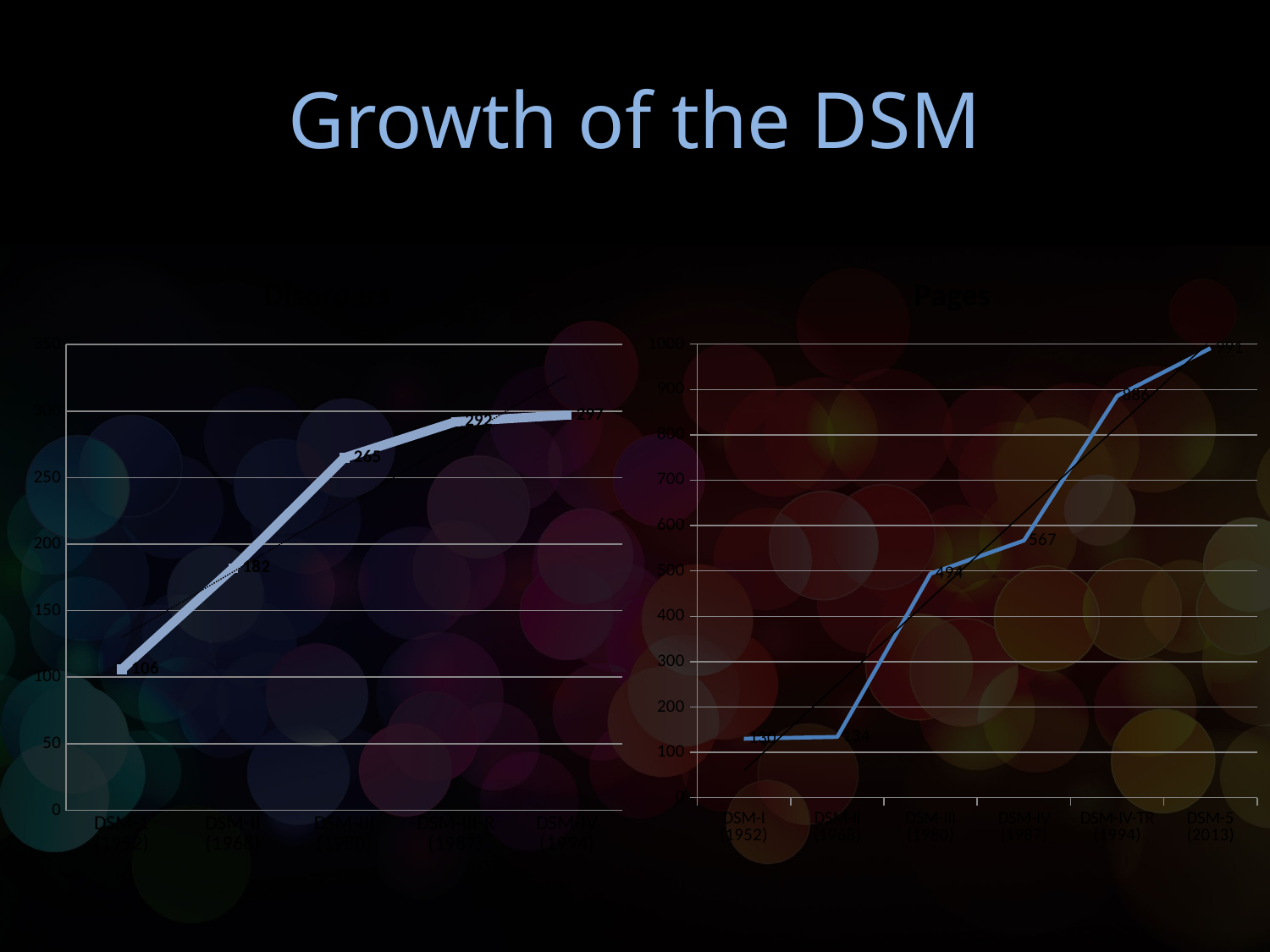
On the left chart, do the values rise or fall from DSM-I (1952) to DSM-IV (1994)? rise On the right chart, what is the difference between the values for DSM-IV (1987) and DSM-III (1980)? 73 On the left chart, what is the difference between the values for DSM-IV (1994) and DSM-III-R (1987)? 5 On the left chart, what is the value for DSM-I (1952)? 106 On the right chart, what is the value for DSM-III (1980)? 494 On the right chart, is the value for DSM-5 (2013) greater or less than 900? greater On the left chart, what is the value for DSM-III (1980)? 265 What kind of chart is the chart on the left of the slide? line chart How many data points are plotted on the left chart? 5 How many data points are plotted on the right chart? 6 On the right chart, what is the value for DSM-IV-TR (1994)? 886 On the right chart, which has the larger value, DSM-II (1968) or DSM-III (1980)? DSM-III (1980)